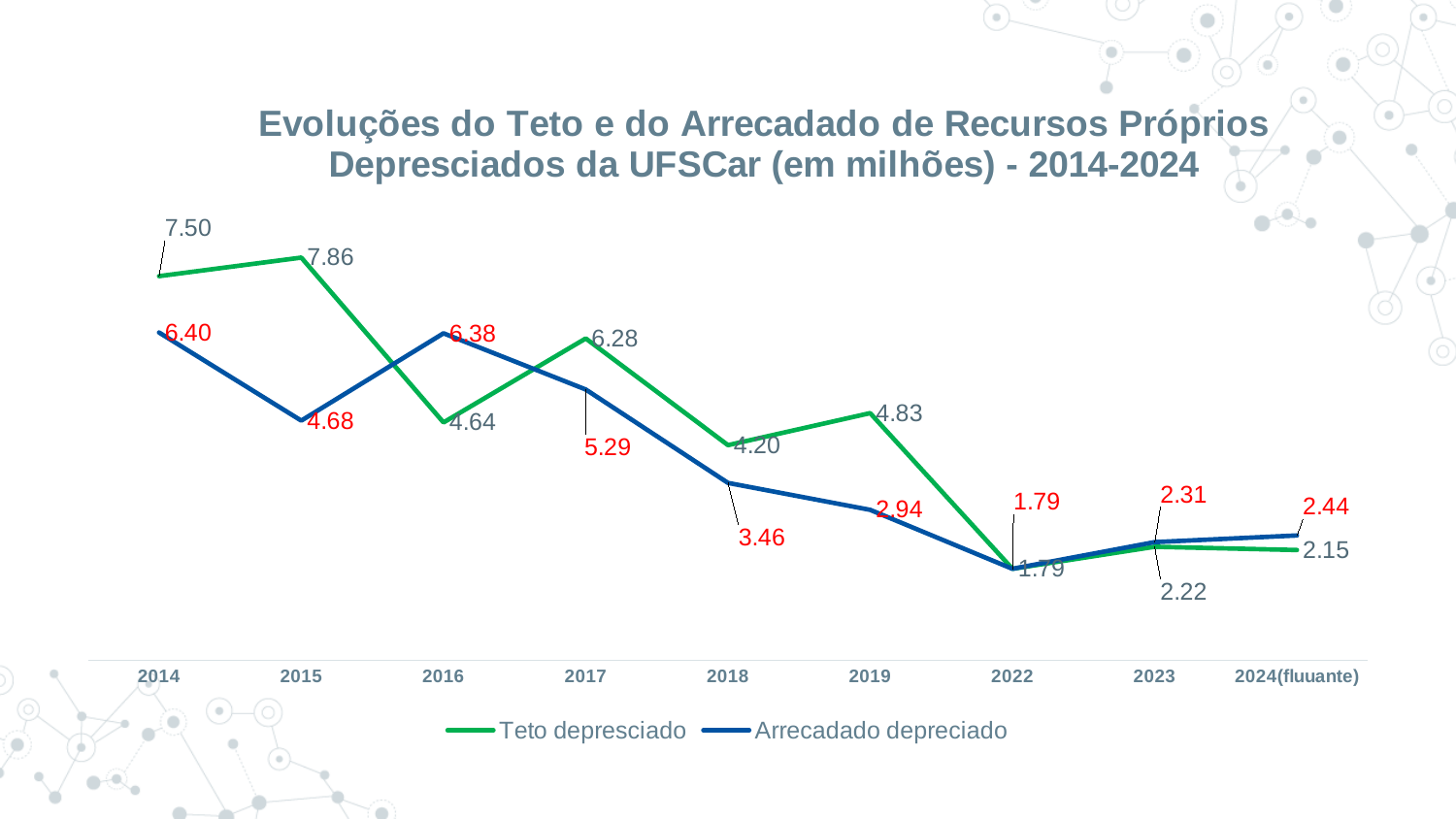
How many series does the legend list? 2 In which year is Teto depresciado at its highest? 2015 What is the value of Arrecadado depreciado in 2024(fluuante)? 2.44 How many years are plotted on the x axis? 9 In 2016, which series has the larger value, Teto depresciado or Arrecadado depreciado? Arrecadado depreciado What is the value of Arrecadado depreciado in 2018? 3.46 Does Teto depresciado overall rise or fall from 2014 to 2024(fluuante)? Fall What kind of chart is shown on the slide? Line chart What is the difference between Teto depresciado and Arrecadado depreciado in 2019? 1.89 In which year is Arrecadado depreciado at its lowest? 2022 What is the difference between Teto depresciado and Arrecadado depreciado in 2014? 1.10 What is the value of Teto depresciado in 2015? 7.86